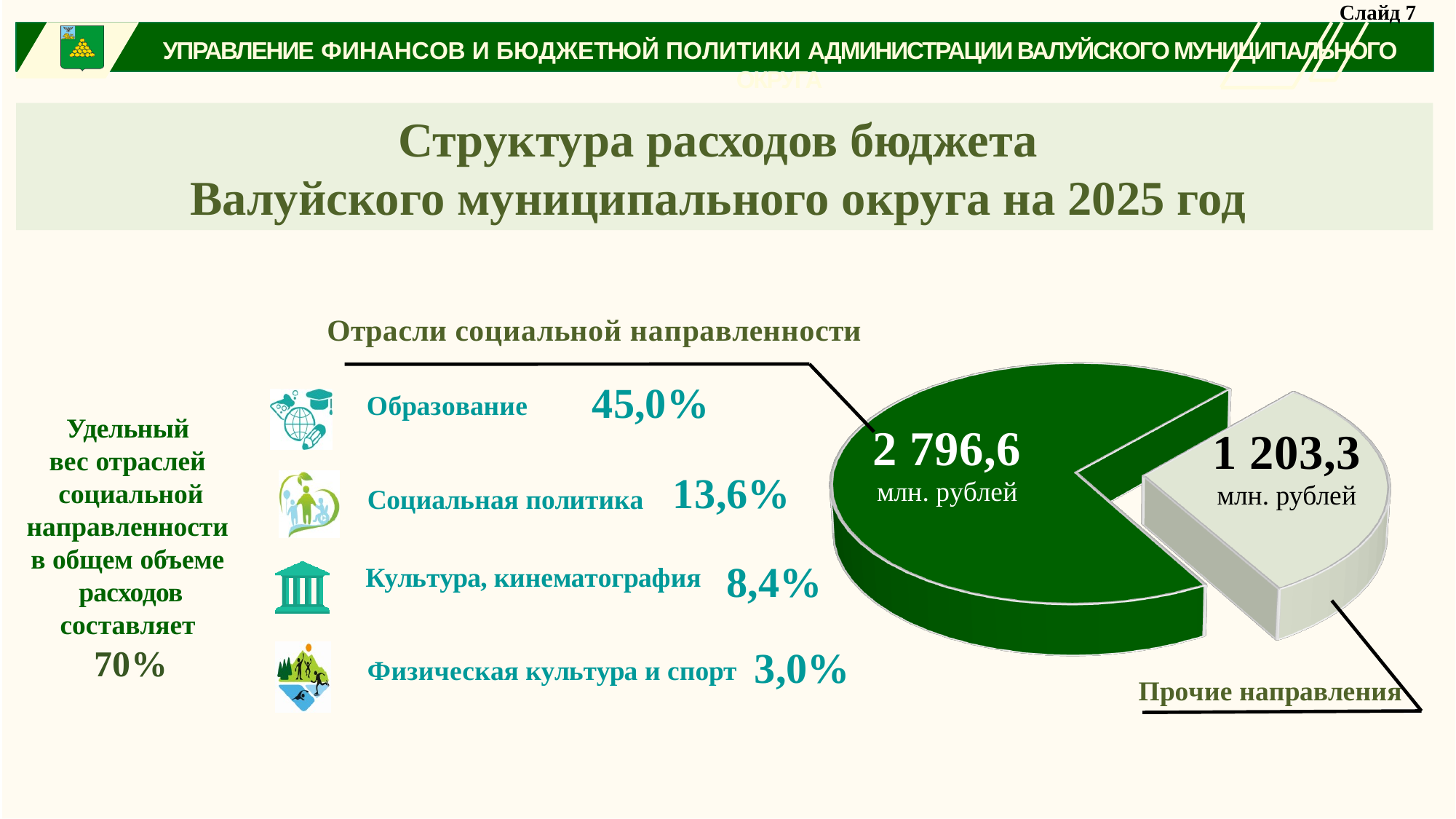
What is the value of the slice for Отрасли социальной направленности? 2 796,6 млн. рублей Which slice of the pie chart is the largest? Отрасли социальной направленности What is the value of the slice for Прочие направления? 1 203,3 млн. рублей What share of total expenditures do the social sectors (Отрасли социальной направленности) make up, according to the slide? 70% Which is larger: the slice for Отрасли социальной направленности or the slice for Прочие направления? Отрасли социальной направленности What is the title of the slide containing the pie chart? Структура расходов бюджета Валуйского муниципального округа на 2025 год Which slice of the pie chart is the smallest? Прочие направления What colour is the slice for Отрасли социальной направленности? green How many slices does the pie chart have? 2 By how much does the slice for Отрасли социальной направленности exceed the slice for Прочие направления? 1 593,3 млн. рублей What is the total of the two slices in the pie chart? 3 999,9 млн. рублей What kind of chart is shown on the slide? pie chart